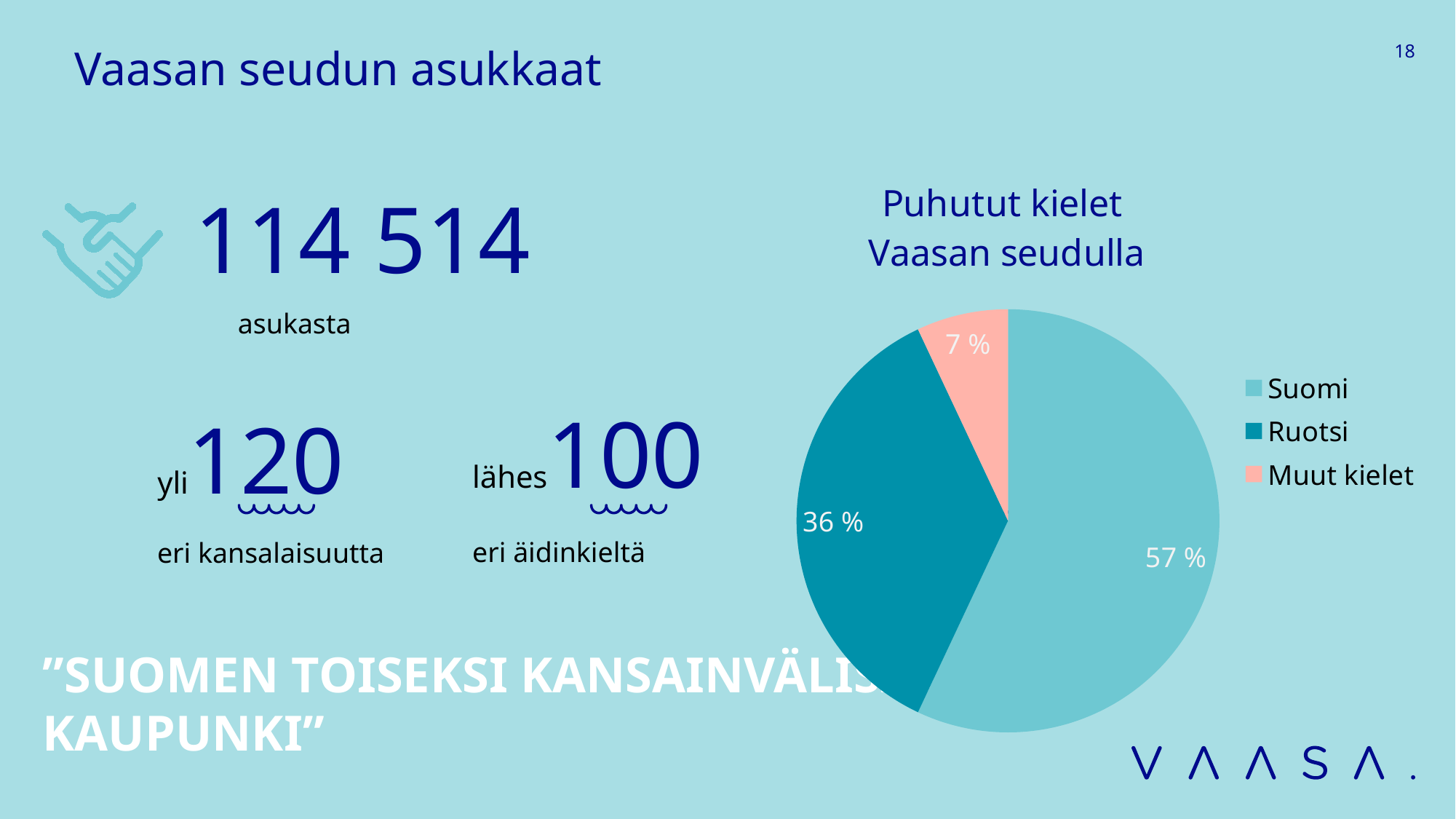
What share of the pie does Ruotsi have? 36 % Which language has the smallest slice of the pie? Muut kielet How many slices does the pie chart have? 3 What share of the pie does Muut kielet have? 7 % What kind of chart is shown on the slide? pie chart Which is larger, the share for Ruotsi or the share for Muut kielet? Ruotsi How many entries does the legend list? 3 What colour is the Muut kielet slice in the pie chart? pink What is the title of the pie chart? Puhutut kielet Vaasan seudulla What share of the pie does Suomi have? 57 % What is the difference in percentage points between Suomi and Ruotsi? 21 Which language has the largest slice of the pie? Suomi